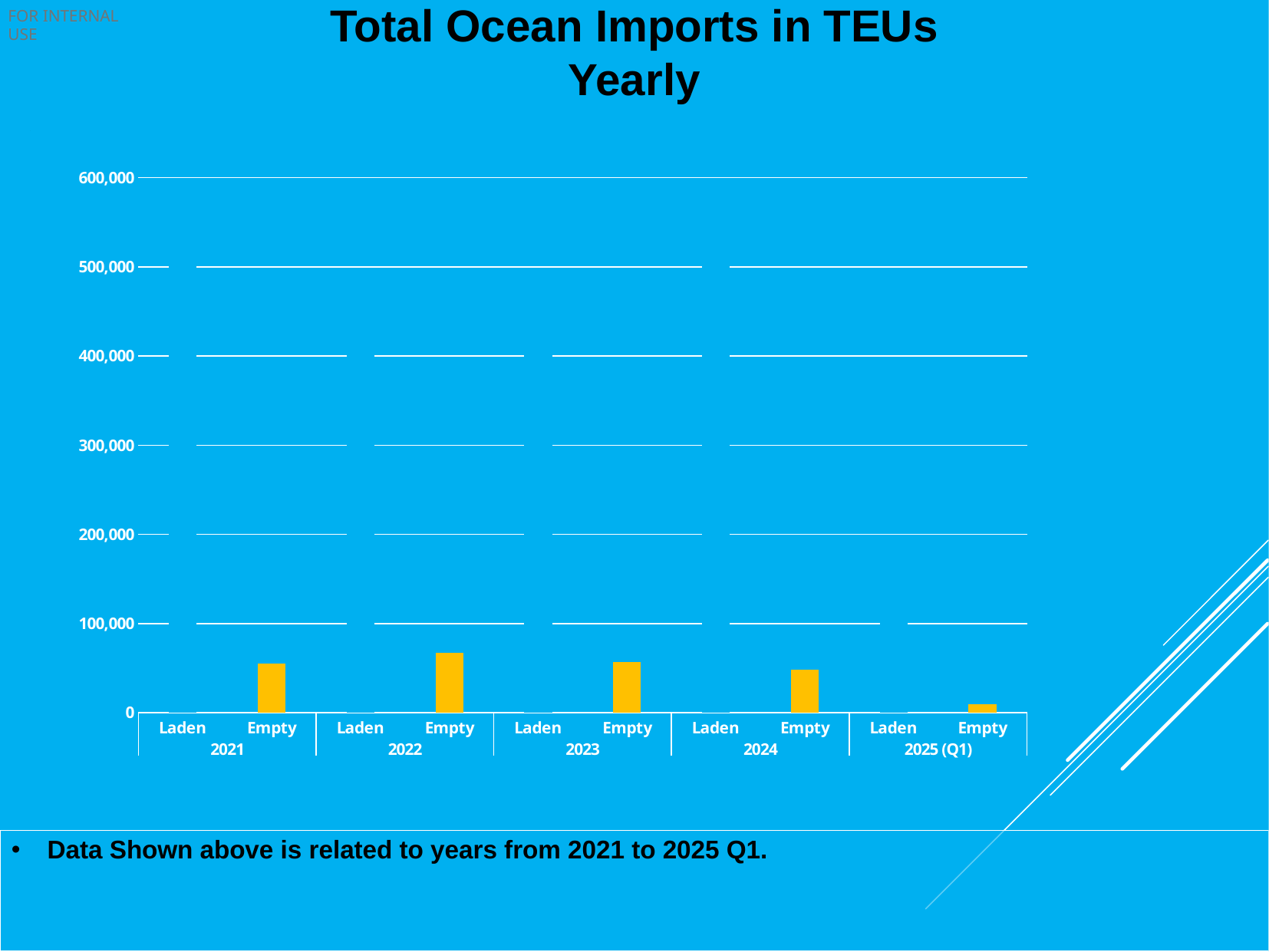
Do the Empty values rise or fall from 2022 to 2025 (Q1)? fall What kind of chart is shown on the slide? bar chart How many year groups are shown along the x axis of the chart? 5 Which year has the highest Empty bar in the chart? 2022 Which is larger, the Empty value for 2022 or the Empty value for 2024? 2022 Which year has the lowest Empty bar in the chart? 2025 (Q1) What is the highest value labelled on the vertical axis of the chart? 600,000 Is the Empty value for 2022 greater or less than 100,000? less What is the title of the chart? Total Ocean Imports in TEUs Yearly What colour are the Empty bars in the chart? yellow Is the Empty value for 2025 (Q1) greater or less than 100,000? less Which is larger, the Empty value for 2021 or the Empty value for 2025 (Q1)? 2021